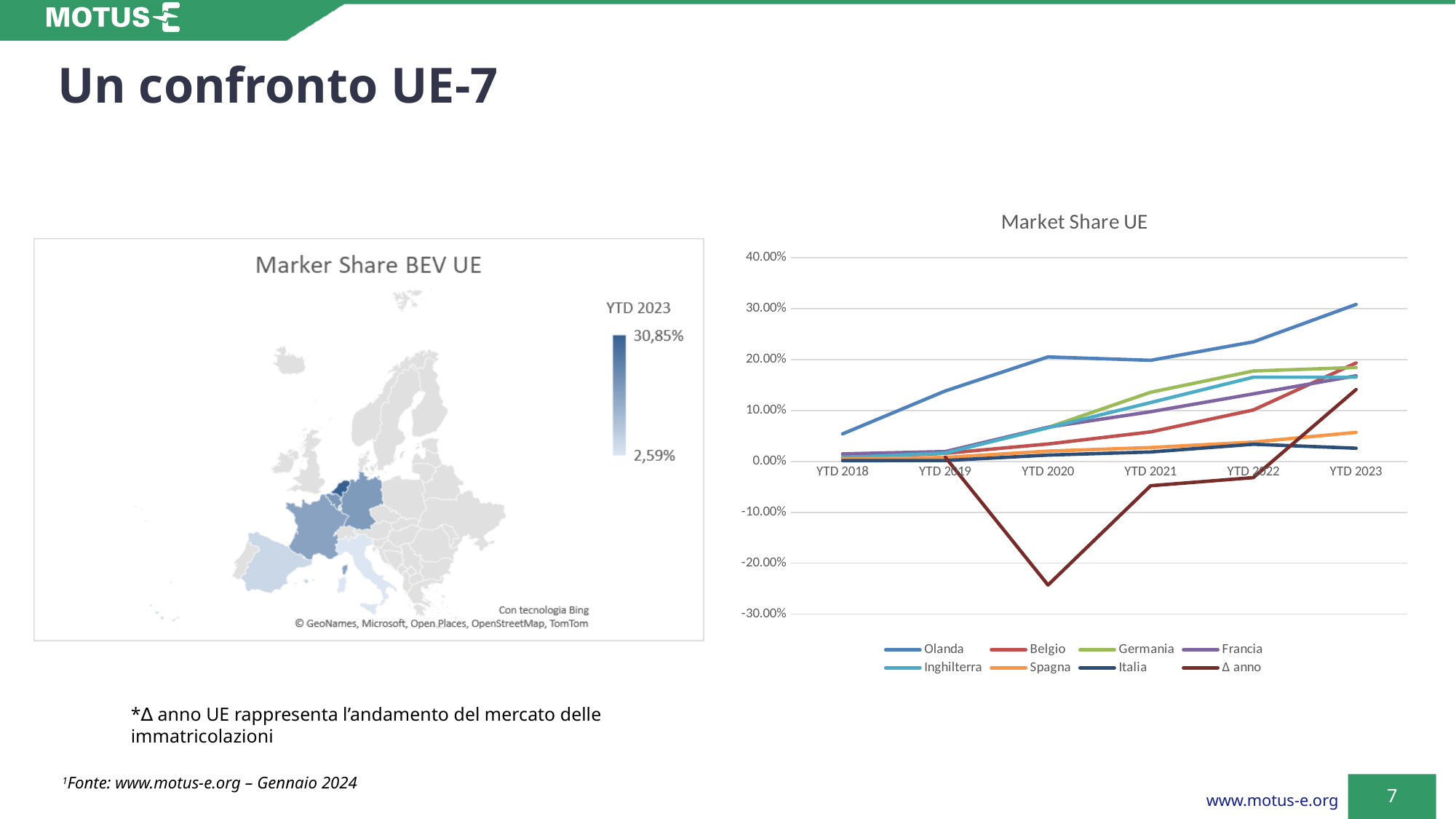
In the 'Market Share UE' chart, at which YTD period does the Δ anno series reach its lowest point? YTD 2020 In the 'Market Share UE' chart, which series has the lowest value at YTD 2023? Italia In the map chart 'Marker Share BEV UE', what is the maximum value shown on the colour legend for YTD 2023? 30,85% In the 'Market Share UE' chart, is the value for Olanda at YTD 2023 greater or less than 20.00%? greater What kind of chart is the 'Market Share UE' chart on the right? line chart In the 'Market Share UE' chart, is the value for Δ anno at YTD 2020 greater or less than -20.00%? less In the 'Market Share UE' chart, does the Olanda series generally rise or fall from YTD 2018 to YTD 2023? rise In the 'Market Share UE' chart, which series has the highest value at YTD 2023? Olanda In the 'Market Share UE' chart, how many YTD periods are shown on the x axis? 6 In the 'Market Share UE' chart, which is larger at YTD 2023: Olanda or Italia? Olanda In the 'Market Share UE' chart, how many series does the legend list? 8 In the 'Market Share UE' chart, is the value for Italia at YTD 2023 greater or less than 10.00%? less